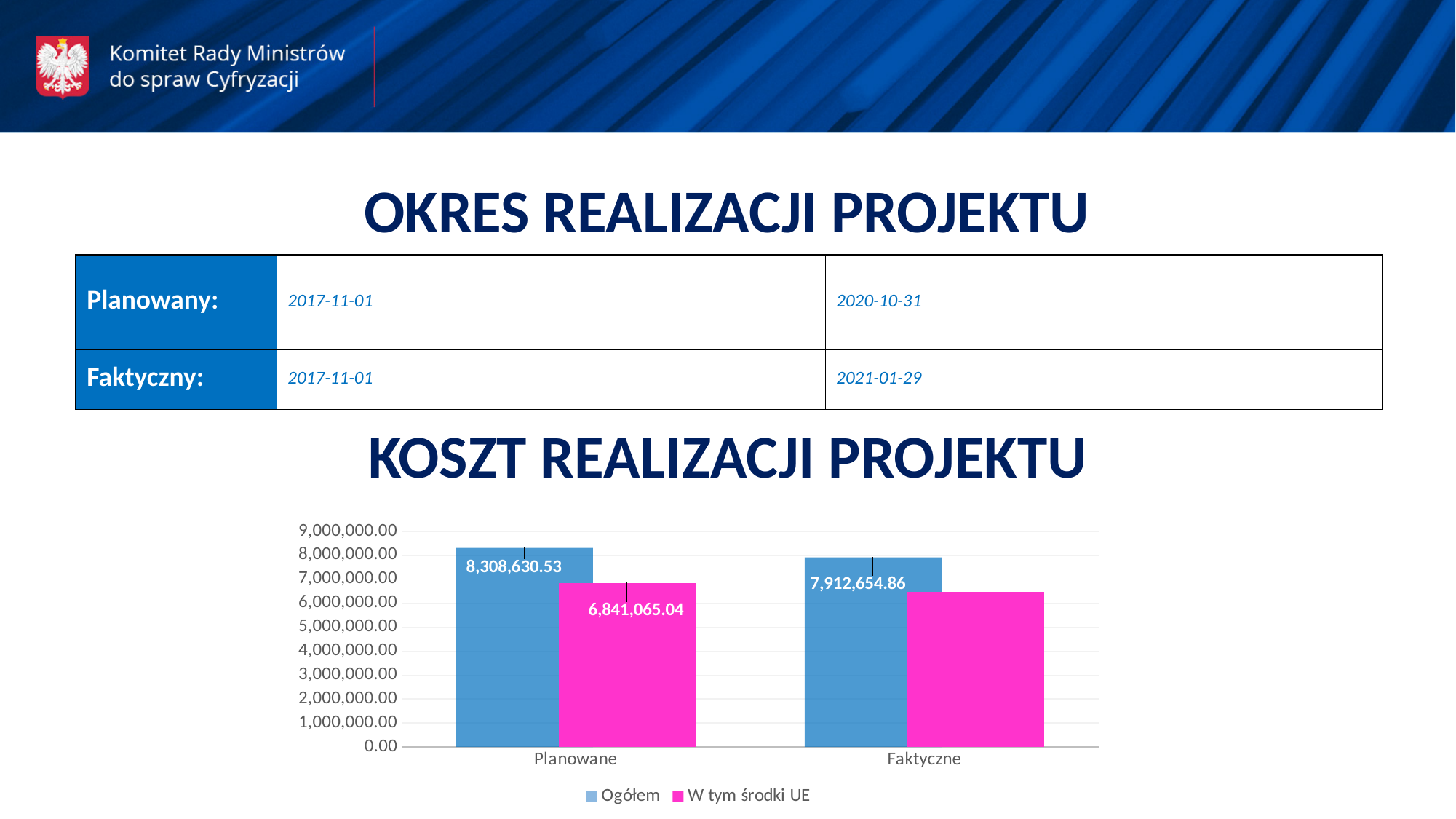
In the KOSZT REALIZACJI PROJEKTU chart, is the W tym środki UE value for Faktyczne greater or less than 7,000,000.00? less What is the value of W tym środki UE for Planowane in the KOSZT REALIZACJI PROJEKTU chart? 6,841,065.04 In the KOSZT REALIZACJI PROJEKTU chart, what is the difference between Ogółem and W tym środki UE for Planowane? 1,467,565.49 In the KOSZT REALIZACJI PROJEKTU chart, which category has the higher Ogółem value? Planowane In the KOSZT REALIZACJI PROJEKTU chart, what is the difference between the Ogółem values for Planowane and Faktyczne? 395,975.67 How many series does the legend of the KOSZT REALIZACJI PROJEKTU chart list? 2 What type of chart is the KOSZT REALIZACJI PROJEKTU chart? bar chart In the KOSZT REALIZACJI PROJEKTU chart, is the W tym środki UE value for Planowane larger or smaller than the W tym środki UE value for Faktyczne? larger What is the value of Ogółem for Planowane in the KOSZT REALIZACJI PROJEKTU chart? 8,308,630.53 What is the value of Ogółem for Faktyczne in the KOSZT REALIZACJI PROJEKTU chart? 7,912,654.86 In the KOSZT REALIZACJI PROJEKTU chart, is the W tym środki UE value for Faktyczne greater or less than 6,000,000.00? greater How many categories are shown on the x axis of the KOSZT REALIZACJI PROJEKTU chart? 2